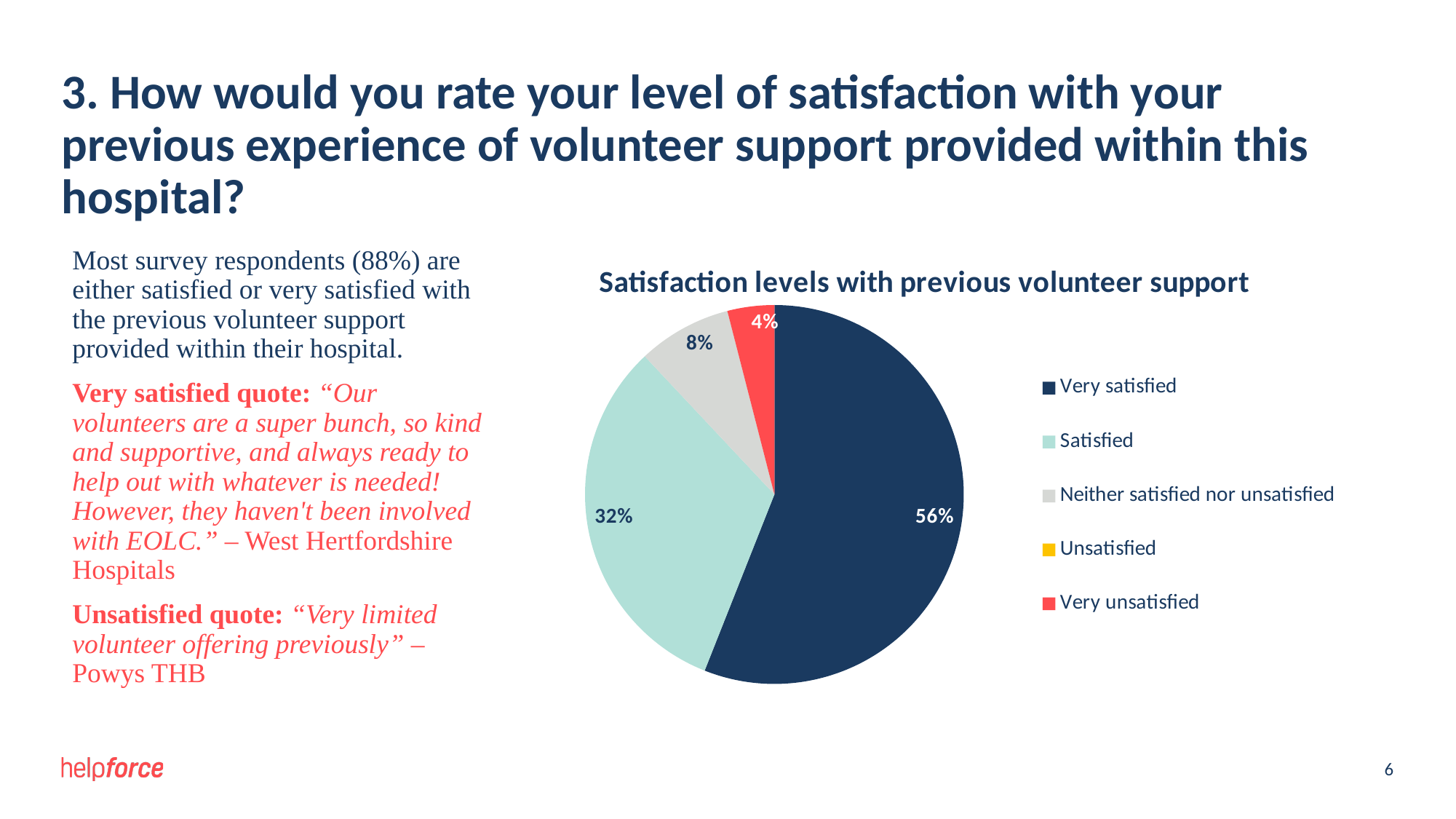
Which category has the largest share of the pie? Very satisfied Which category with a visible slice has the smallest share of the pie? Very unsatisfied What is the title of the chart? Satisfaction levels with previous volunteer support What percentage of respondents were neither satisfied nor unsatisfied? 8% What percentage of respondents were very unsatisfied? 4% What percentage of respondents were satisfied? 32% How many categories does the legend list? 5 What percentage of respondents were very satisfied? 56% What colour is the Very unsatisfied slice? Red What kind of chart is shown on the slide? Pie chart What is the difference in percentage points between the Very satisfied and Satisfied slices? 24 Which is larger, the Satisfied slice or the Neither satisfied nor unsatisfied slice? Satisfied